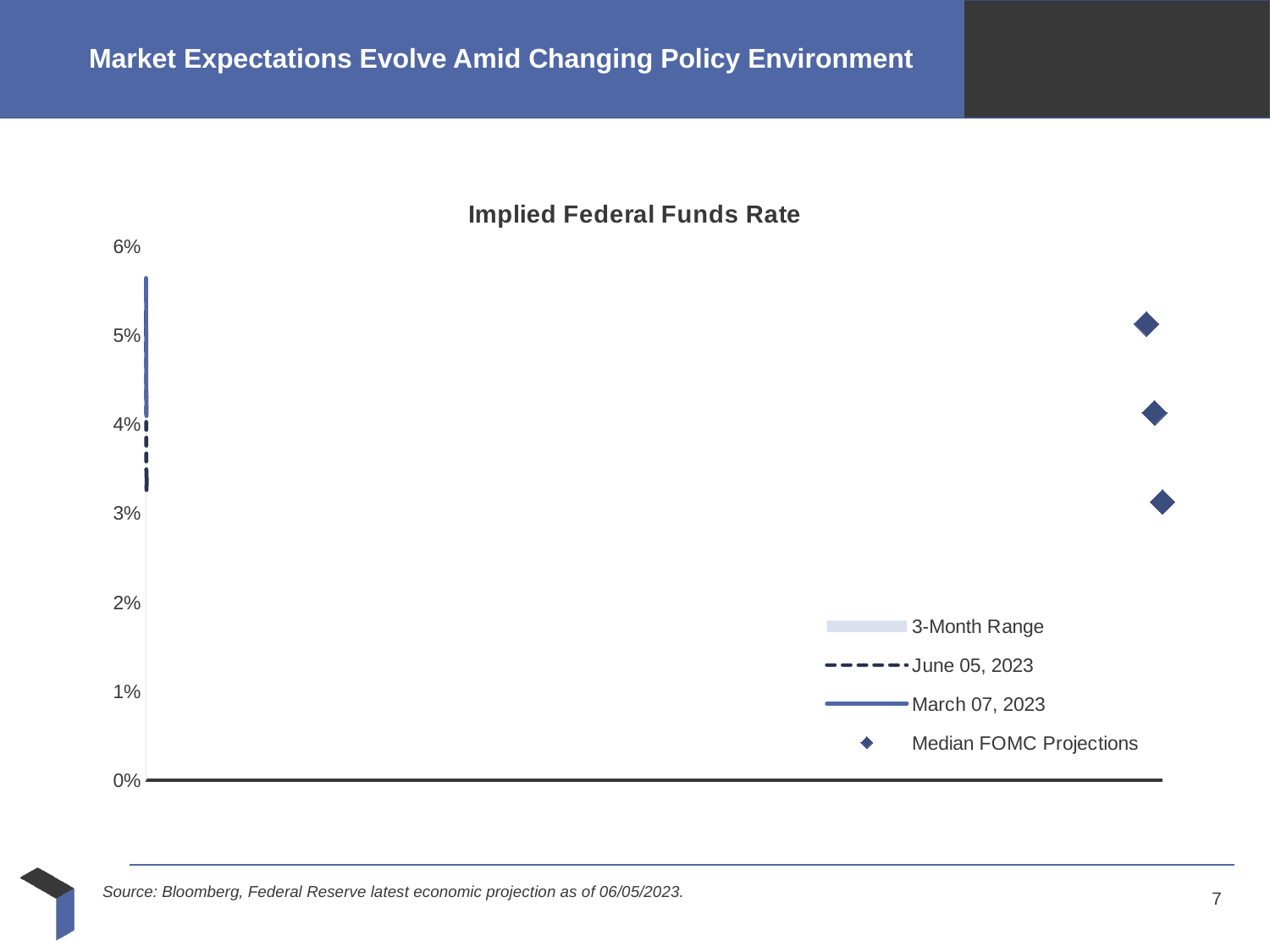
How many series does the chart's legend list? 4 Is the middle Median FOMC Projections marker greater or less than 3%? greater Do the Median FOMC Projections markers rise or fall from left to right? fall What is the title of the chart? Implied Federal Funds Rate Which legend entry is shown with a dashed line? June 05, 2023 Is the lowest Median FOMC Projections marker greater or less than 4%? less Is the highest Median FOMC Projections marker greater or less than 4%? greater How many Median FOMC Projections diamond markers are plotted on the chart? 3 What is the highest value shown on the vertical axis? 6%